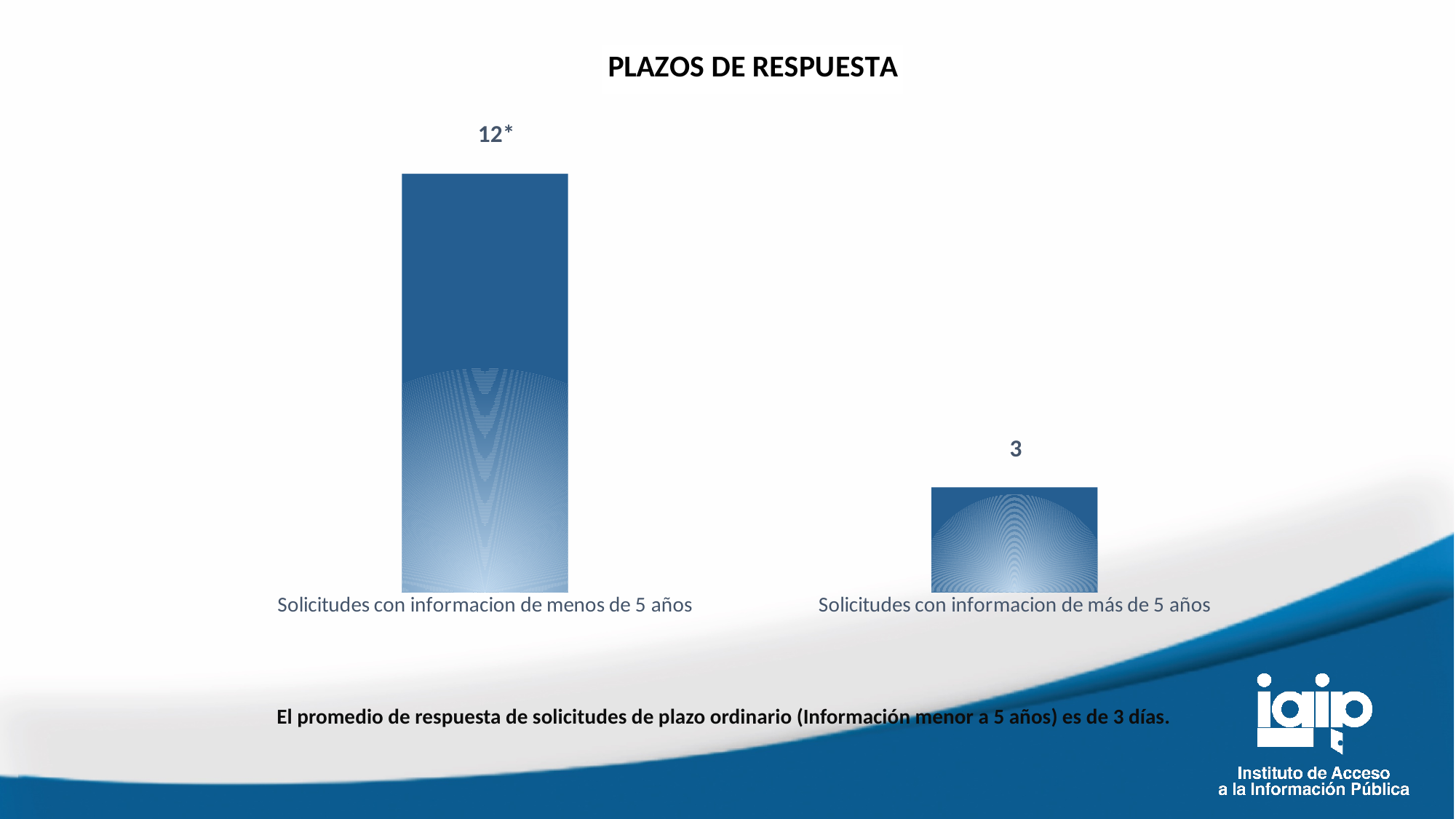
Which data label in the chart is marked with an asterisk? 12* What is the title of the chart? PLAZOS DE RESPUESTA Which is larger: the value for "Solicitudes con informacion de menos de 5 años" or the value for "Solicitudes con informacion de más de 5 años"? Solicitudes con informacion de menos de 5 años What is the value for "Solicitudes con informacion de más de 5 años"? 3 What is the value for "Solicitudes con informacion de menos de 5 años"? 12 What kind of chart is shown on the slide? Bar chart Which category has the highest value? Solicitudes con informacion de menos de 5 años Which category has the lowest value? Solicitudes con informacion de más de 5 años What is the difference between the value for "Solicitudes con informacion de menos de 5 años" and the value for "Solicitudes con informacion de más de 5 años"? 9 How many categories are shown in the chart? 2